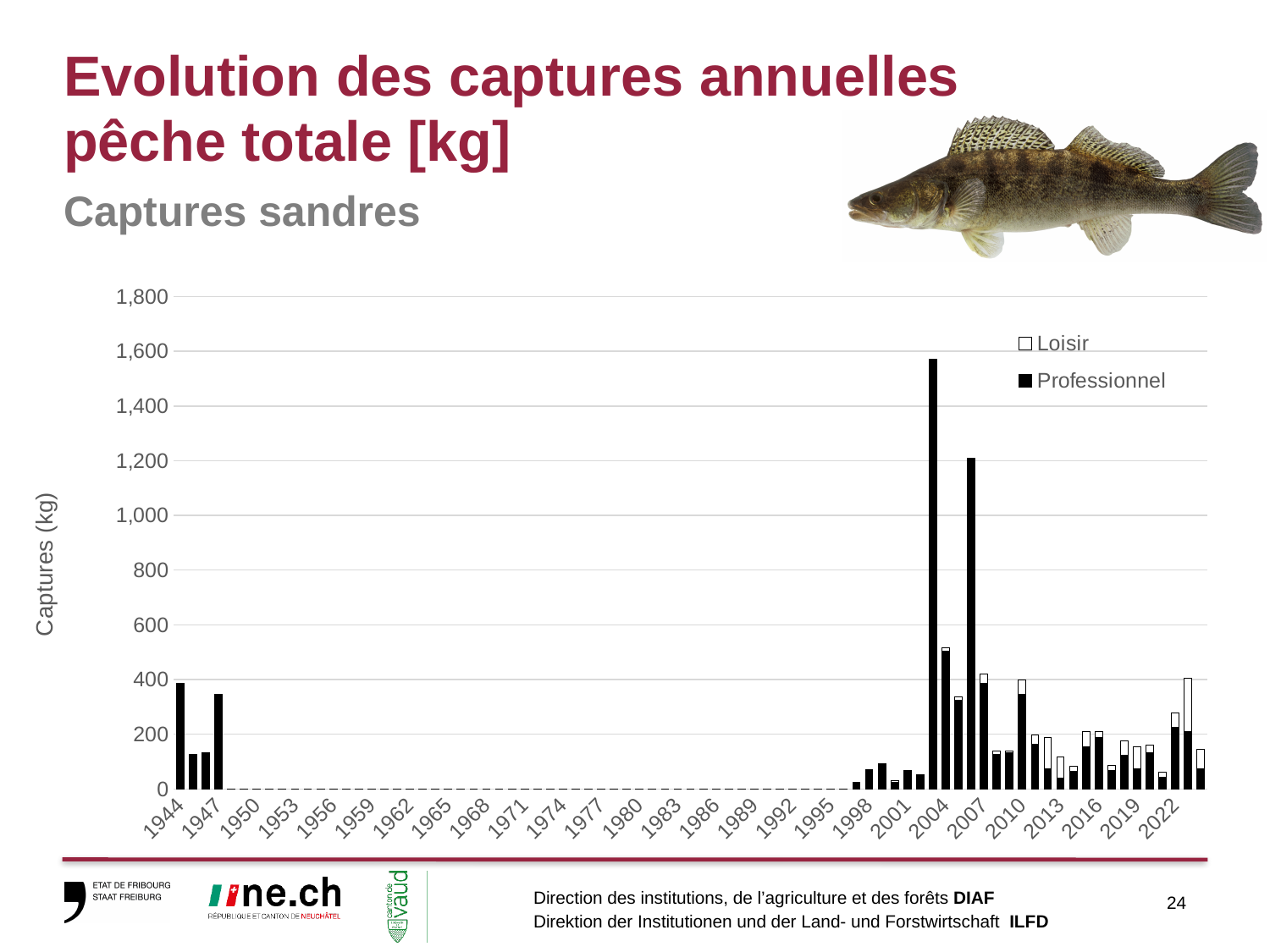
What kind of chart is shown on the slide? Bar chart Which year has the larger total catch, 2004 or 2007? 2004 How many series does the legend list? 2 What is the label of the vertical axis? Captures (kg) Between 1950 and 1995, are the catches high or essentially zero? Essentially zero Is the total catch for 2004 greater or less than 1,400? less Which year has the highest total catch? 2003 Which year has the larger total catch, 1944 or 1998? 1944 Is the total catch for 1944 greater or less than 200? greater Is the total catch for 2007 greater or less than 1,000? less What are the two series named in the legend? Loisir and Professionnel